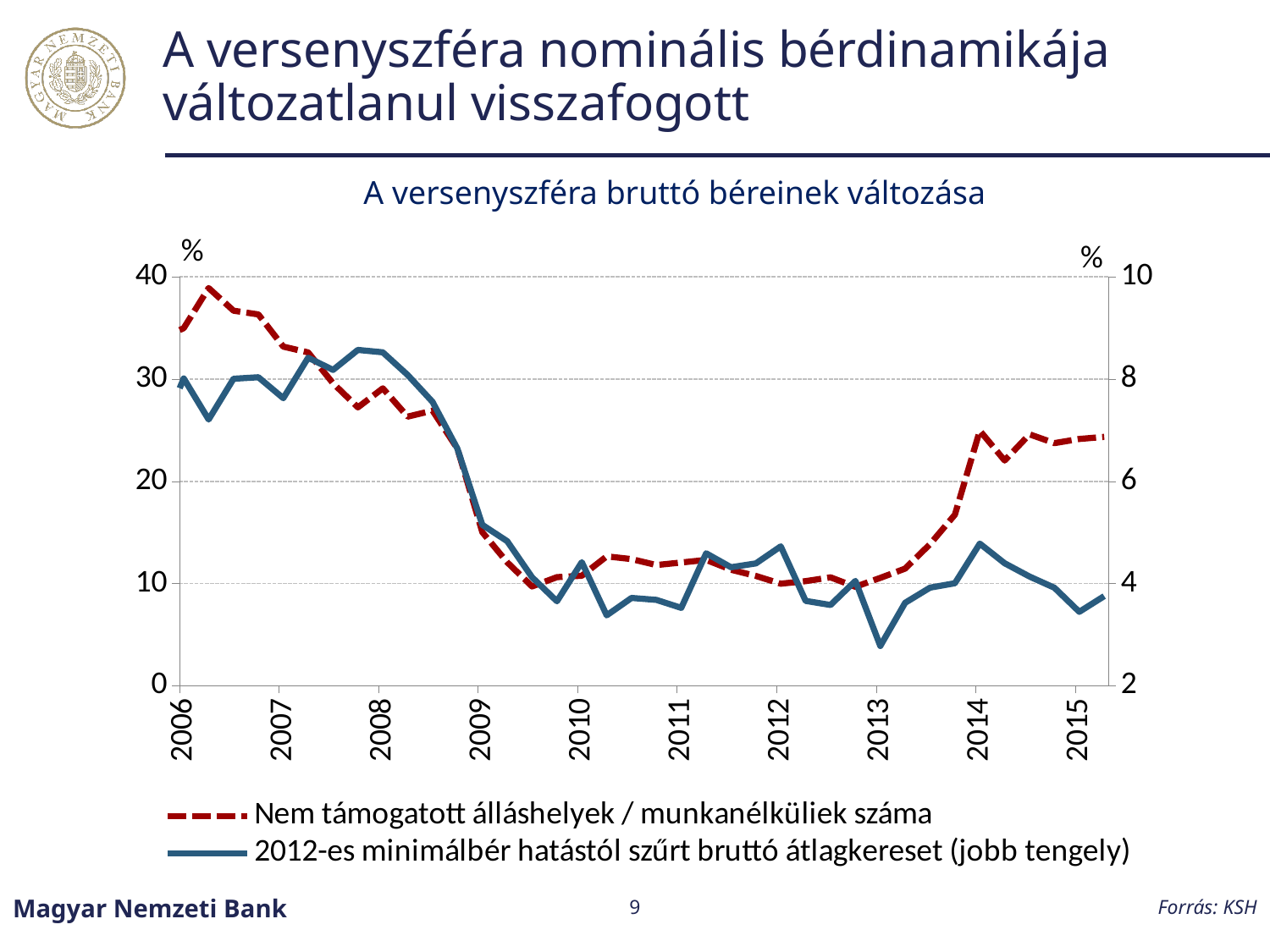
What kind of chart is shown on the slide? line chart What is the title of the chart? A versenyszféra bruttó béreinek változása Which series is plotted on the right axis (jobb tengely)? 2012-es minimálbér hatástól szűrt bruttó átlagkereset Is the value of the dashed series (Nem támogatott álláshelyek / munkanélküliek száma) at the start of 2006 greater or less than 30? greater Is the value of the dashed series (Nem támogatott álláshelyek / munkanélküliek száma) at the start of 2014 greater or less than 20? greater Does the dashed series (Nem támogatott álláshelyek / munkanélküliek száma) rise or fall between 2006 and 2009? fall Is the dashed series (Nem támogatott álláshelyek / munkanélküliek száma) higher at the start of 2006 or at the start of 2012? 2006 How many series does the legend list? 2 Is the value of the solid series (2012-es minimálbér hatástól szűrt bruttó átlagkereset) at the start of 2008 greater or less than 8 on the right axis? greater Does the dashed series (Nem támogatott álláshelyek / munkanélküliek száma) rise or fall between 2013 and 2014? rise How many year labels are shown on the x axis? 10